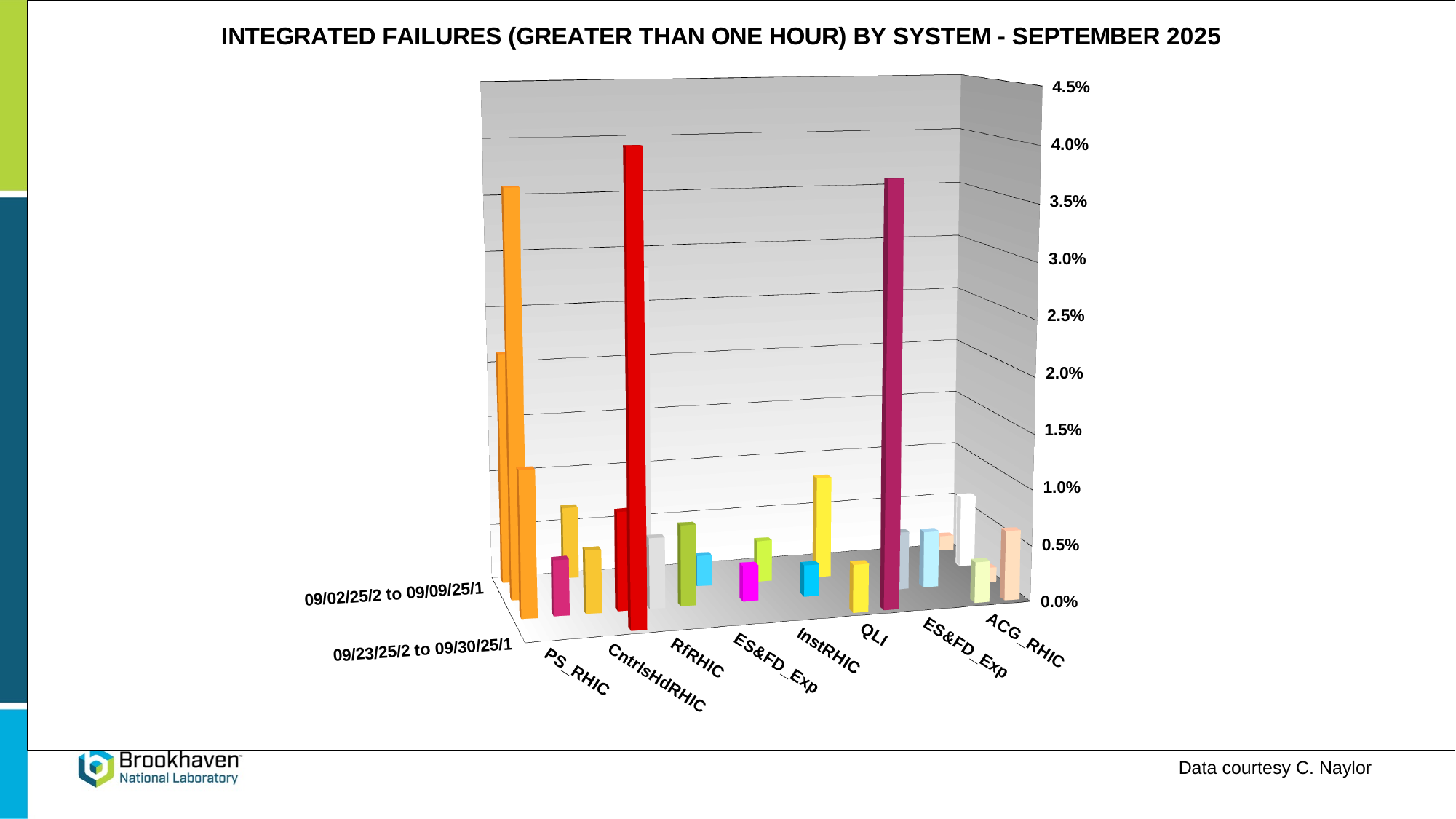
How many system categories are labelled along the x axis? 8 Is the tallest bar for ACG_RHIC greater or less than 1.0%? less What kind of chart is shown on the slide? bar chart Which is larger, the tallest bar for CntrlsHdRHIC or the tallest bar for InstRHIC? CntrlsHdRHIC Which is larger, the tallest bar for QLI or the tallest bar for ACG_RHIC? QLI Is the tallest bar for InstRHIC greater or less than 1.5%? less What is the highest value shown on the vertical axis? 4.5% Is the tallest bar for PS_RHIC greater or less than 2.0%? greater What is the title of the chart? INTEGRATED FAILURES (GREATER THAN ONE HOUR) BY SYSTEM - SEPTEMBER 2025